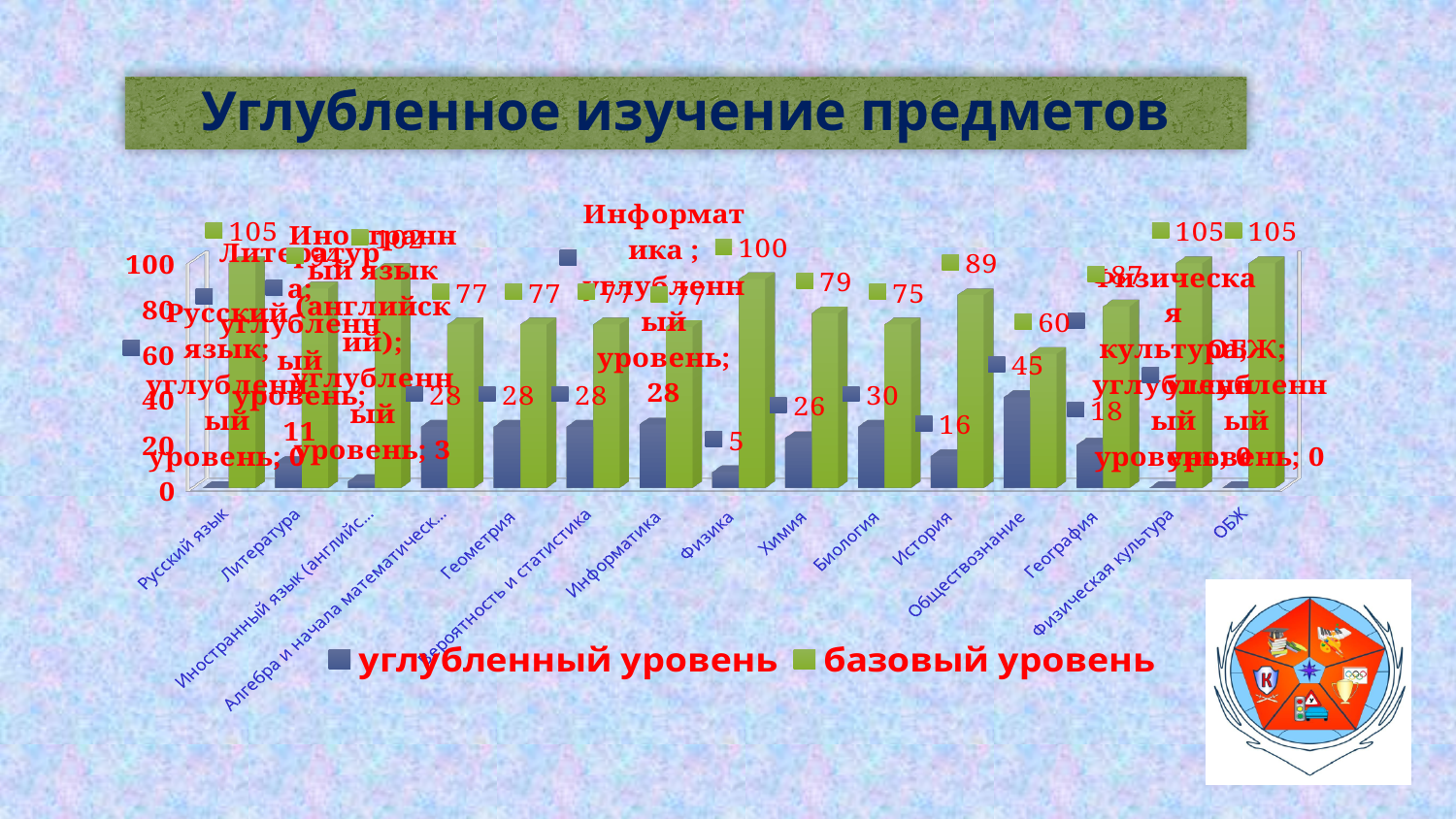
What kind of chart is shown on the slide? bar chart What is the title of the chart? Углубленное изучение предметов What is the value of углубленный уровень for Обществознание? 45 Which subject has the lowest value for базовый уровень? Обществознание Which subject has the highest value for углубленный уровень? Обществознание What is the value of базовый уровень for Физика? 100 How many series does the legend list? 2 Which is larger for География: углубленный уровень or базовый уровень? базовый уровень What is the value of углубленный уровень for Химия? 26 What is the value of базовый уровень for История? 89 What is the difference between базовый уровень and углубленный уровень for Биология? 45 How many subject categories are shown on the x axis? 15